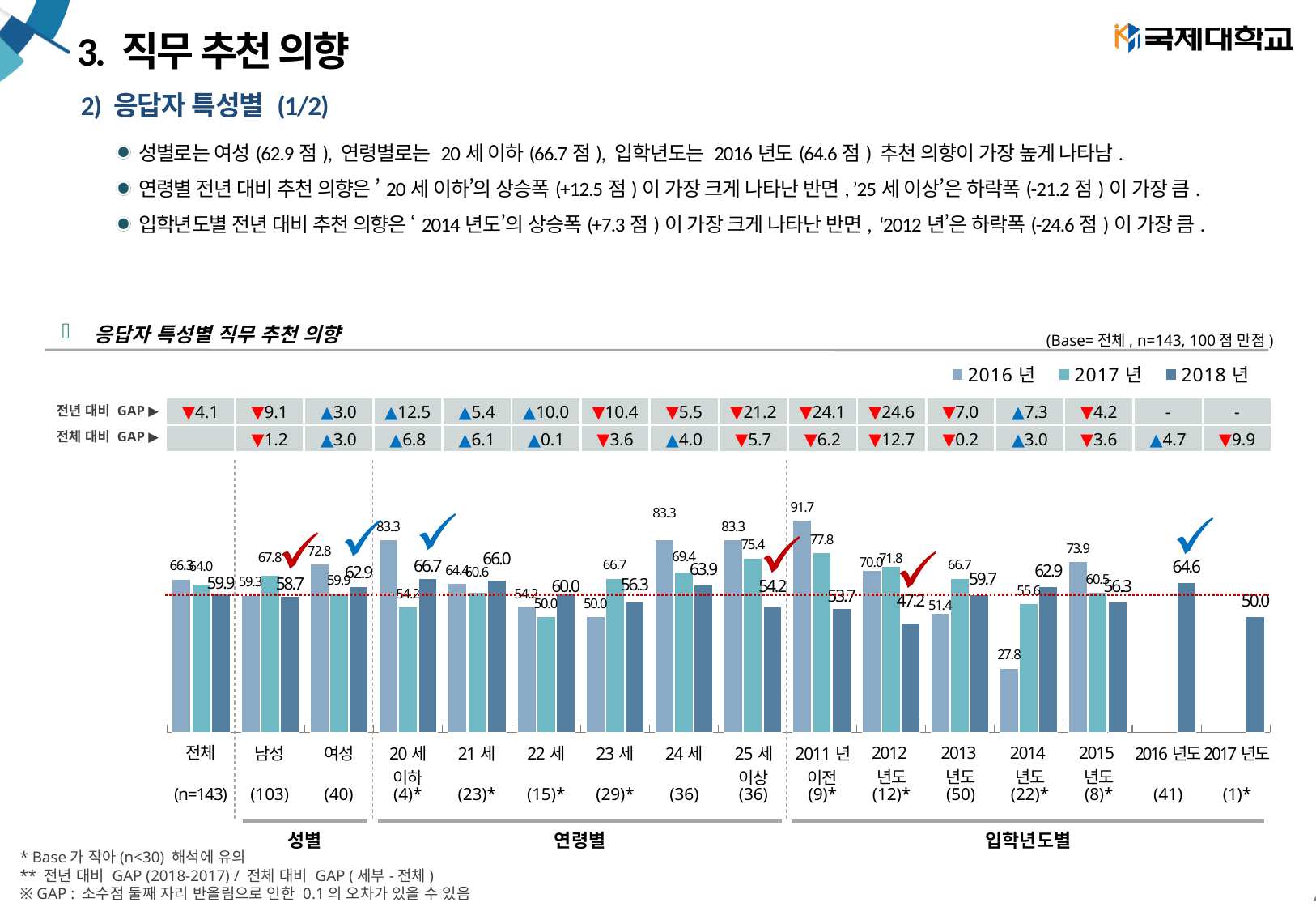
For 23세, which is larger: the 2016년 value or the 2017년 value? 2017년 What is the 2018년 value for 여성? 62.9 What is the title of the chart? 응답자 특성별 직무 추천 의향 What is the 2017년 value for 25세 이상? 75.4 Which category has the lowest 2018년 value? 2012년도 What is the difference between the 2016년 and 2018년 values for 20세 이하? 16.6 What kind of chart is shown on the slide? bar chart What is the 2016년 value for 2011년 이전? 91.7 Which category has the lowest 2016년 value? 2014년도 How many categories are shown on the x axis of the chart? 16 How many series does the chart legend list? 3 What is the 2018년 value for 2016년도? 64.6